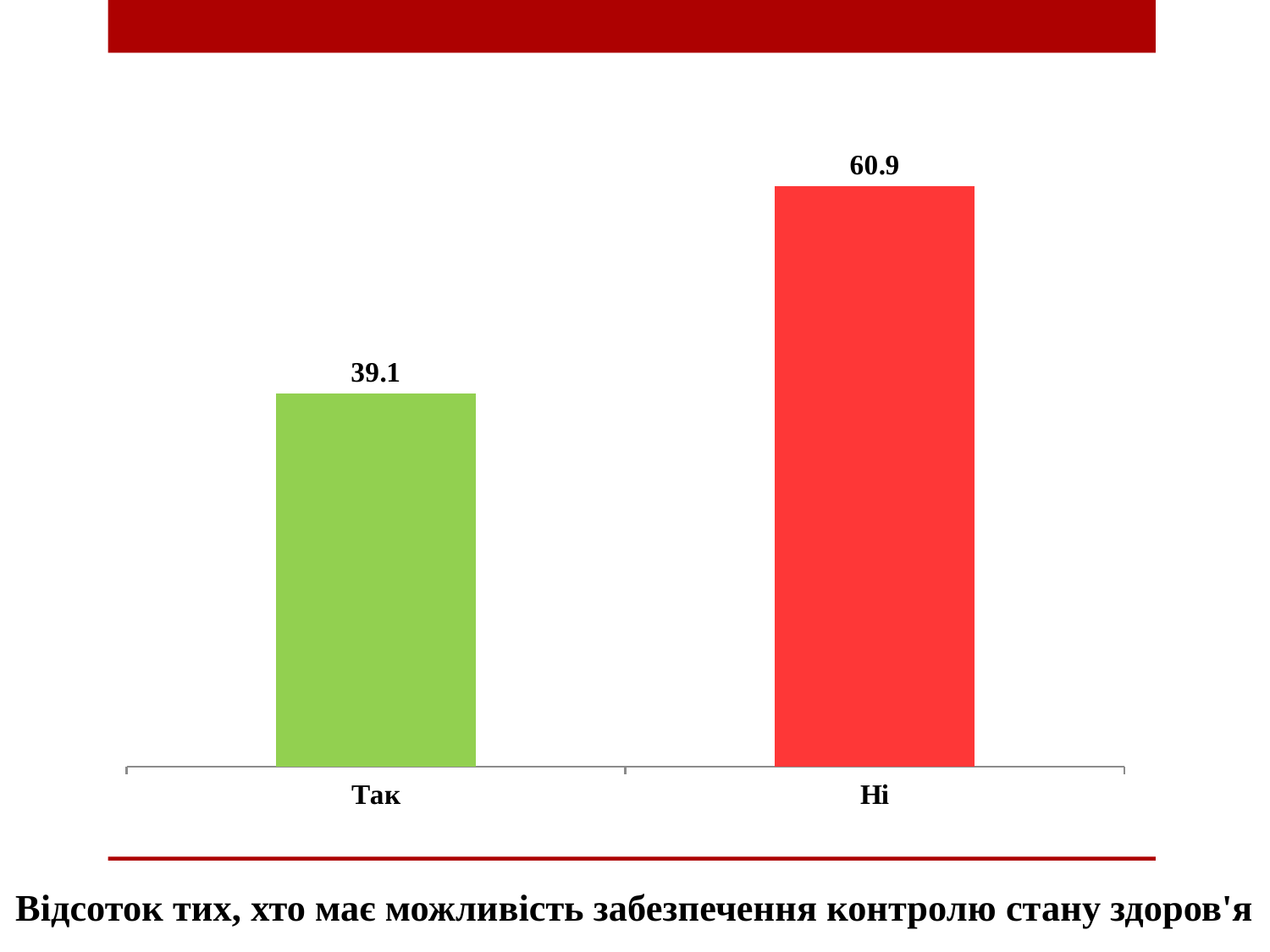
What colour is the bar for "Так"? Green What kind of chart is shown on the slide? Bar chart Which category has the lowest value? Так What is the value for "Так"? 39.1 What is the difference between the values for "Ні" and "Так"? 21.8 Which category has the highest value? Ні What is the value for "Ні"? 60.9 What is the total of the two values shown in the chart? 100 Which is larger, the value for "Так" or the value for "Ні"? Ні How many categories are shown in the chart? 2 What colour is the bar for "Ні"? Red